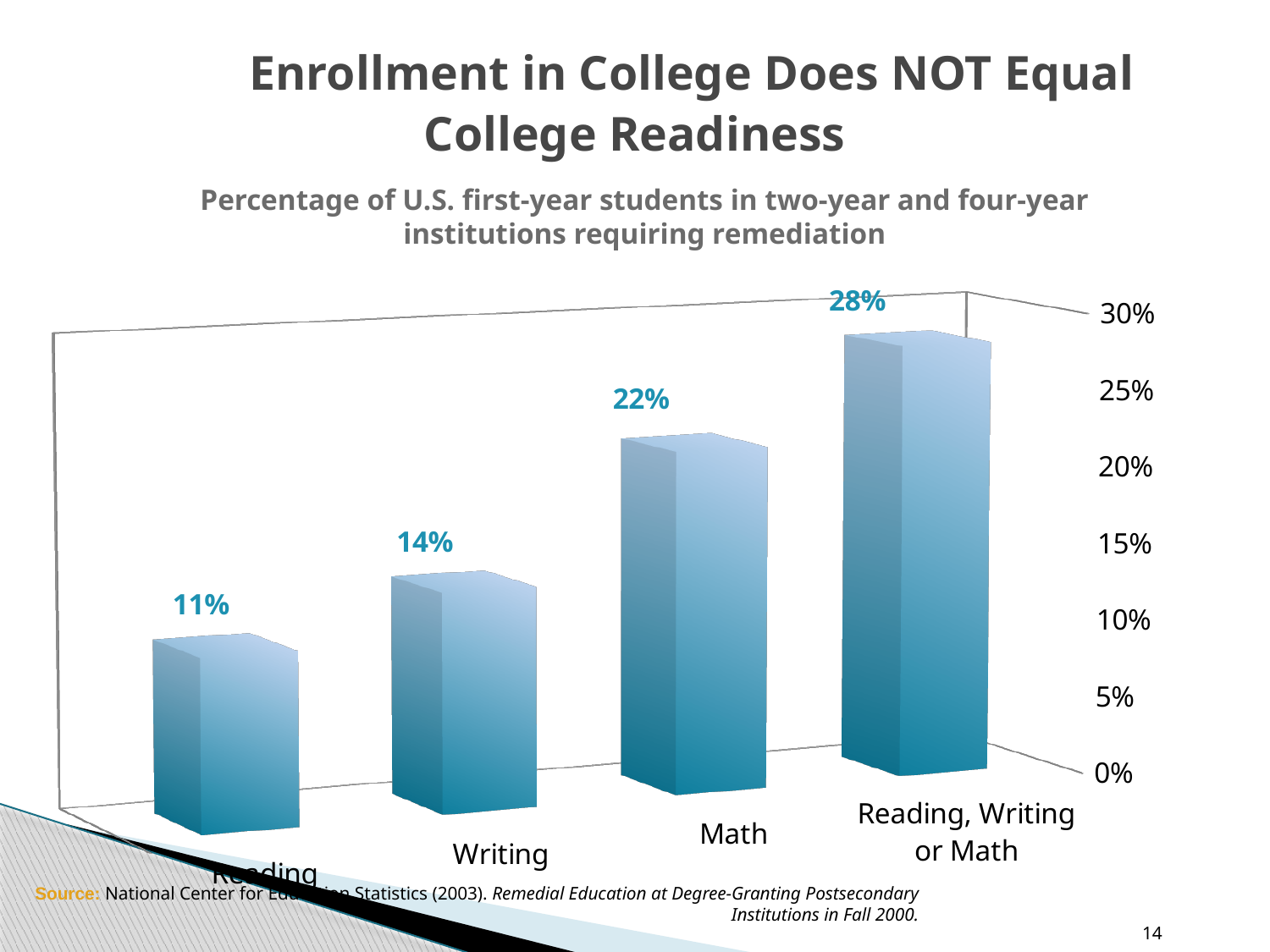
How many categories are shown in the chart? 4 Which category has the highest percentage of students requiring remediation? Reading, Writing or Math Which is larger, the value for Math or the value for Writing? Math What is the difference in percentage points between Reading, Writing or Math and Reading? 17 Do the values rise or fall from left to right across the categories? Rise What percentage of first-year students require remediation in Reading, Writing or Math? 28% Which category has the lowest percentage of students requiring remediation? Reading What percentage of first-year students require remediation in Reading? 11% What percentage of first-year students require remediation in Math? 22% What is the difference in percentage points between Math and Writing? 8 What percentage of first-year students require remediation in Writing? 14% What kind of chart is shown on the slide? Bar chart